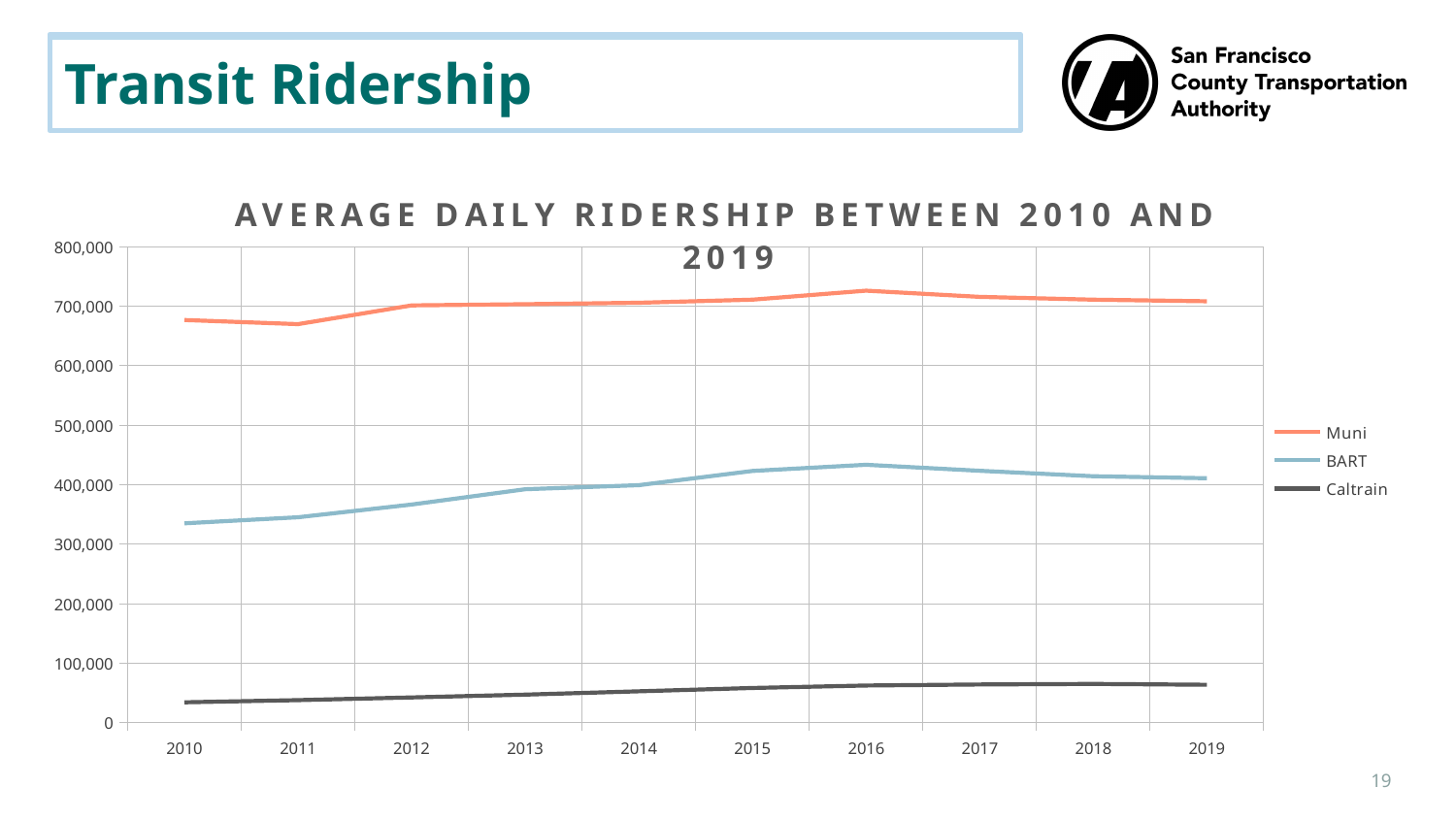
Is the Caltrain value for 2019 greater or less than 100,000? less Which is larger in 2015, the BART value or the Caltrain value? BART Which series has the highest ridership across all years? Muni What kind of chart is shown on the slide? line chart Which series has the lowest ridership across all years? Caltrain Is the BART value for 2010 greater or less than 400,000? less What is the title of the chart? AVERAGE DAILY RIDERSHIP BETWEEN 2010 AND 2019 Does the BART line generally rise or fall between 2010 and 2016? rise Is the Muni value for 2010 greater or less than 600,000? greater How many series does the legend list? 3 How many years are shown on the x axis? 10